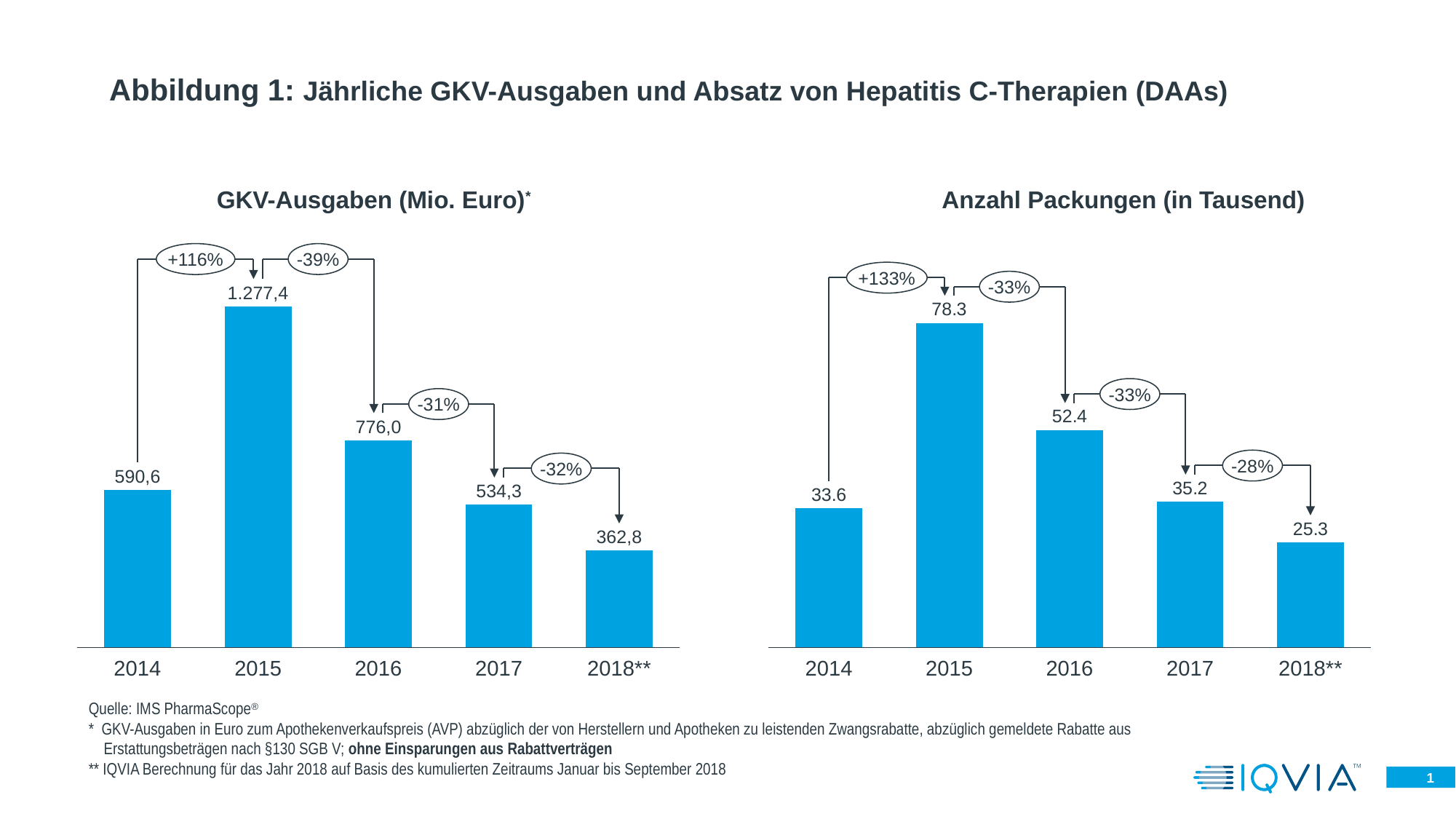
In the 'GKV-Ausgaben (Mio. Euro)' chart, do the values rise or fall from 2015 to 2018**? fall In the 'GKV-Ausgaben (Mio. Euro)' chart, what is the difference between the values for 2016 and 2017? 241,7 In the 'Anzahl Packungen (in Tausend)' chart, what percentage change is shown between 2014 and 2015? +133% In the 'Anzahl Packungen (in Tausend)' chart, which is larger, the value for 2014 or the value for 2017? 2017 How many years are shown on the x axis of the 'GKV-Ausgaben (Mio. Euro)' chart? 5 In the 'Anzahl Packungen (in Tausend)' chart, which year has the highest value? 2015 In the 'Anzahl Packungen (in Tausend)' chart, what is the difference between the values for 2014 and 2018**? 8.3 In the 'GKV-Ausgaben (Mio. Euro)' chart, which year has the lowest value? 2018** What kind of chart is the 'Anzahl Packungen (in Tausend)' chart? bar chart In the 'GKV-Ausgaben (Mio. Euro)' chart, what is the value for 2018**? 362,8 In the 'GKV-Ausgaben (Mio. Euro)' chart, what is the value for 2015? 1.277,4 In the 'Anzahl Packungen (in Tausend)' chart, what is the value for 2016? 52.4